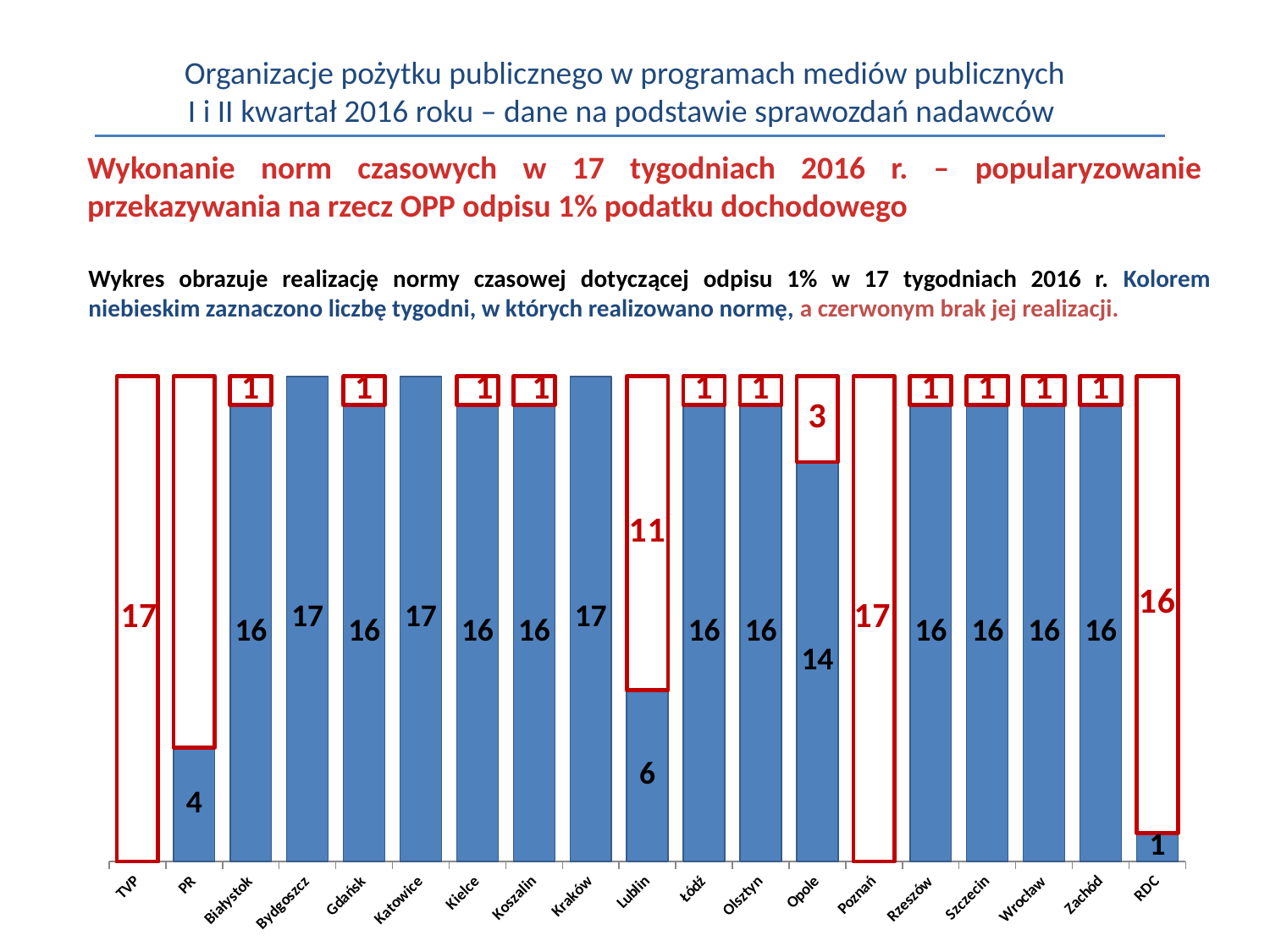
Which category has the lowest blue value among those with a printed blue label? RDC How many weeks did Lublin realize the norm (blue value)? 6 What is the red value for TVP? 17 What is the blue value for PR? 4 Which colour marks the weeks in which the norm was realized? Blue What is the red (norm not realized) value for Opole? 3 How many categories are shown on the x axis? 19 What is the difference between the blue values for Opole and Lublin? 8 What type of chart is shown on the slide? Stacked bar chart What is the red value for RDC? 16 What is the total of the stacked bar for Opole (blue plus red)? 17 Which category has the largest red (norm not realized) value, TVP or Lublin? TVP